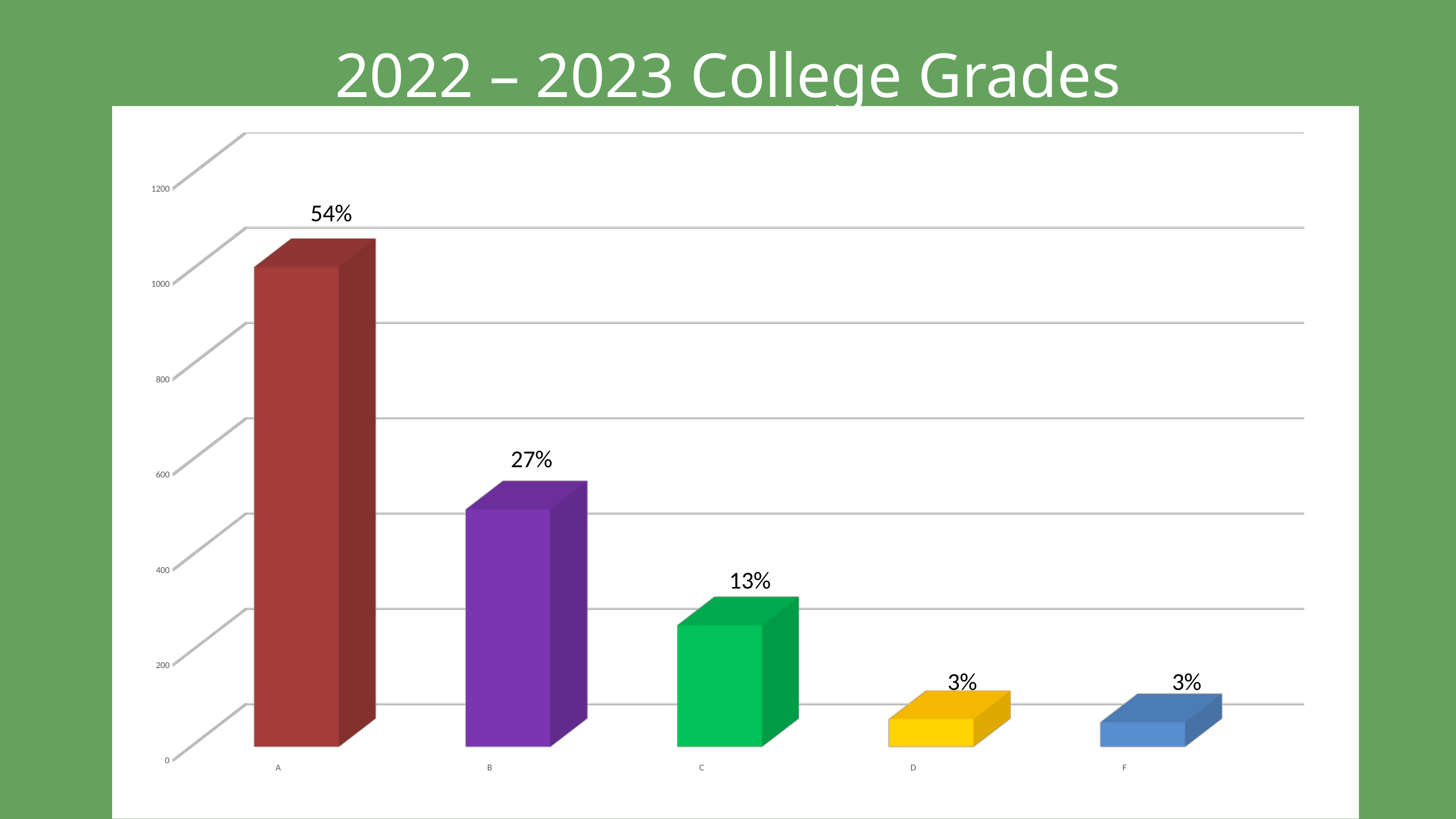
Which is larger, the value for grade B or the value for grade C? B What kind of chart is shown on the slide? bar chart What is the data label shown for grade D? 3% What is the difference between the labelled values for grade A and grade B? 27% What is the data label shown for grade C? 13% Is the bar for grade D greater or less than 200 on the vertical axis? less What is the data label shown for grade A? 54% Which grade has the highest value? A What is the data label shown for grade B? 27% Is the bar for grade A greater or less than 800 on the vertical axis? greater Do the values rise or fall moving from grade A to grade F along the x axis? fall How many grade categories are shown on the chart? 5